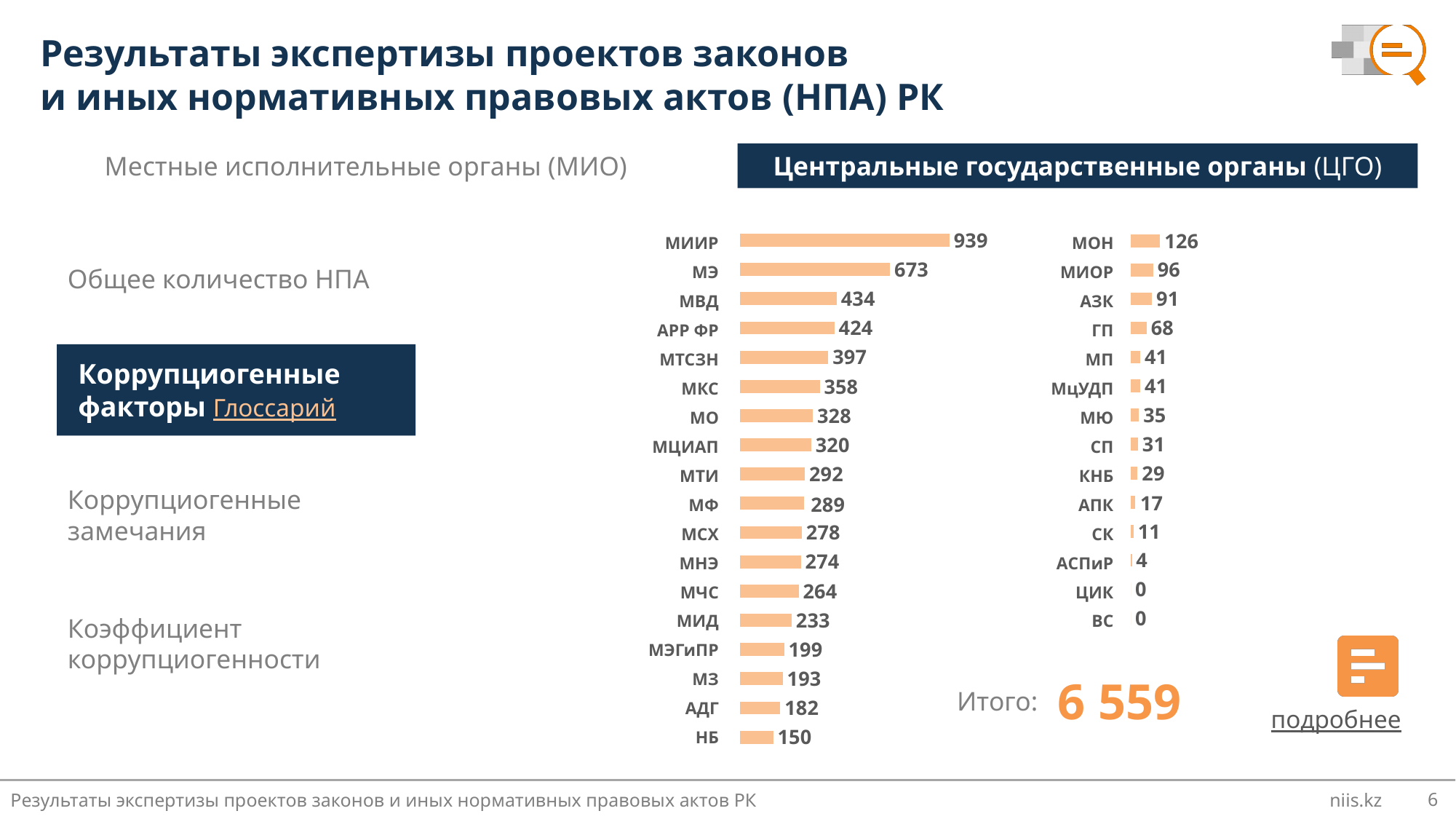
What total (Итого) is shown for the chart? 6 559 What is the value for АСПиР? 4 What kind of chart is shown? Bar chart Which category has the highest value? МИИР What is the value for АЗК? 91 What is the value for МТСЗН? 397 What is the difference between the values for МИИР and МЭ? 266 Which categories have a value of 0? ЦИК and ВС How many categories are shown in the chart? 32 What is the value for МИИР? 939 Which is larger, the value for МВД or the value for АРР ФР? МВД What is the difference between the values for МОН and МИОР? 30